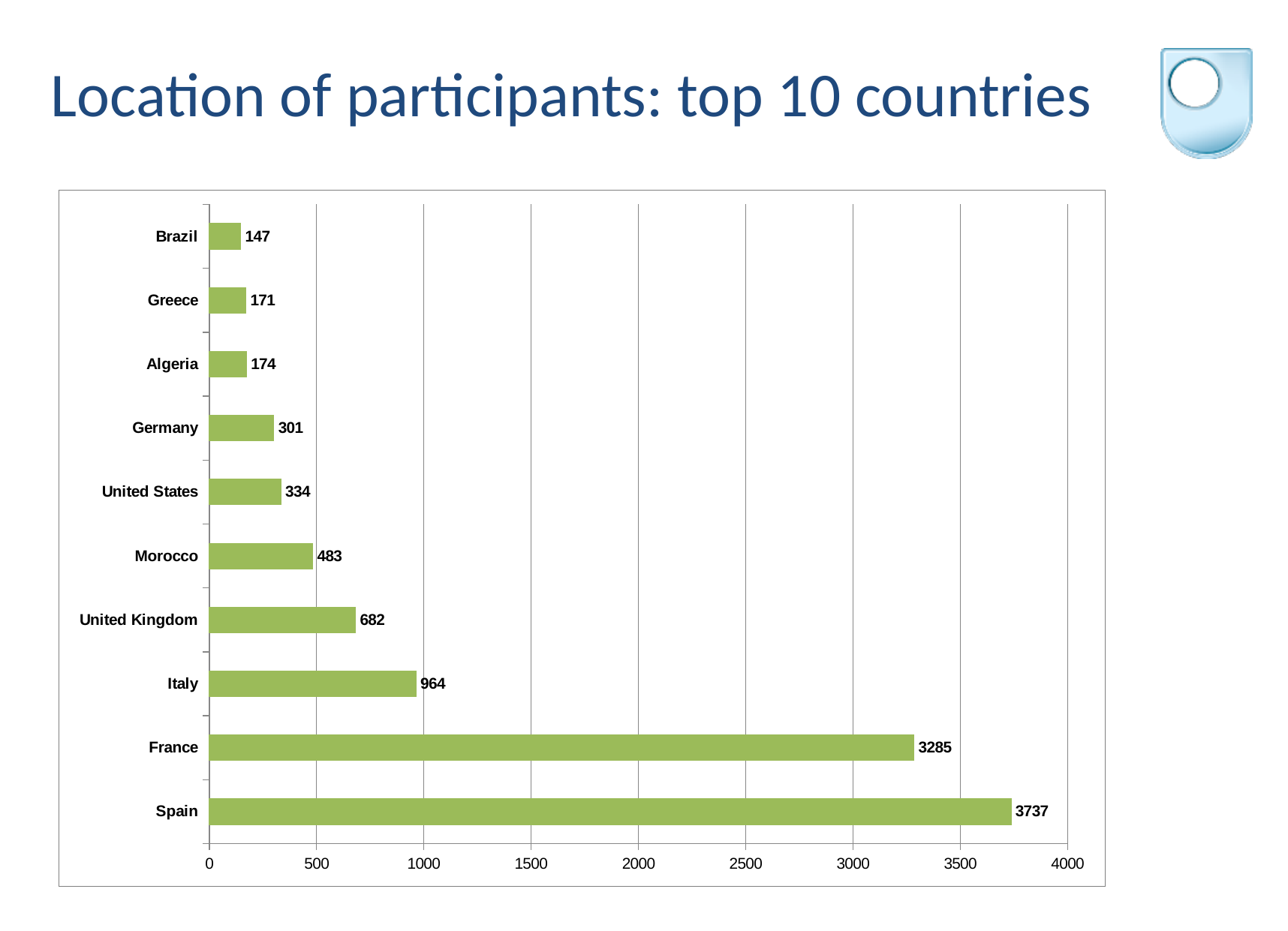
Which country has the highest value? Spain Is the value for France greater or less than 3000? greater How many countries are shown in the chart? 10 What is the value for Spain? 3737 Which country has the lowest value? Brazil What is the difference between the values for Italy and United Kingdom? 282 What is the value for Germany? 301 What is the title of the slide? Location of participants: top 10 countries What kind of chart is shown on the slide? bar chart What is the value for Morocco? 483 Which has a larger value, United States or Morocco? Morocco What is the difference between the values for Spain and France? 452